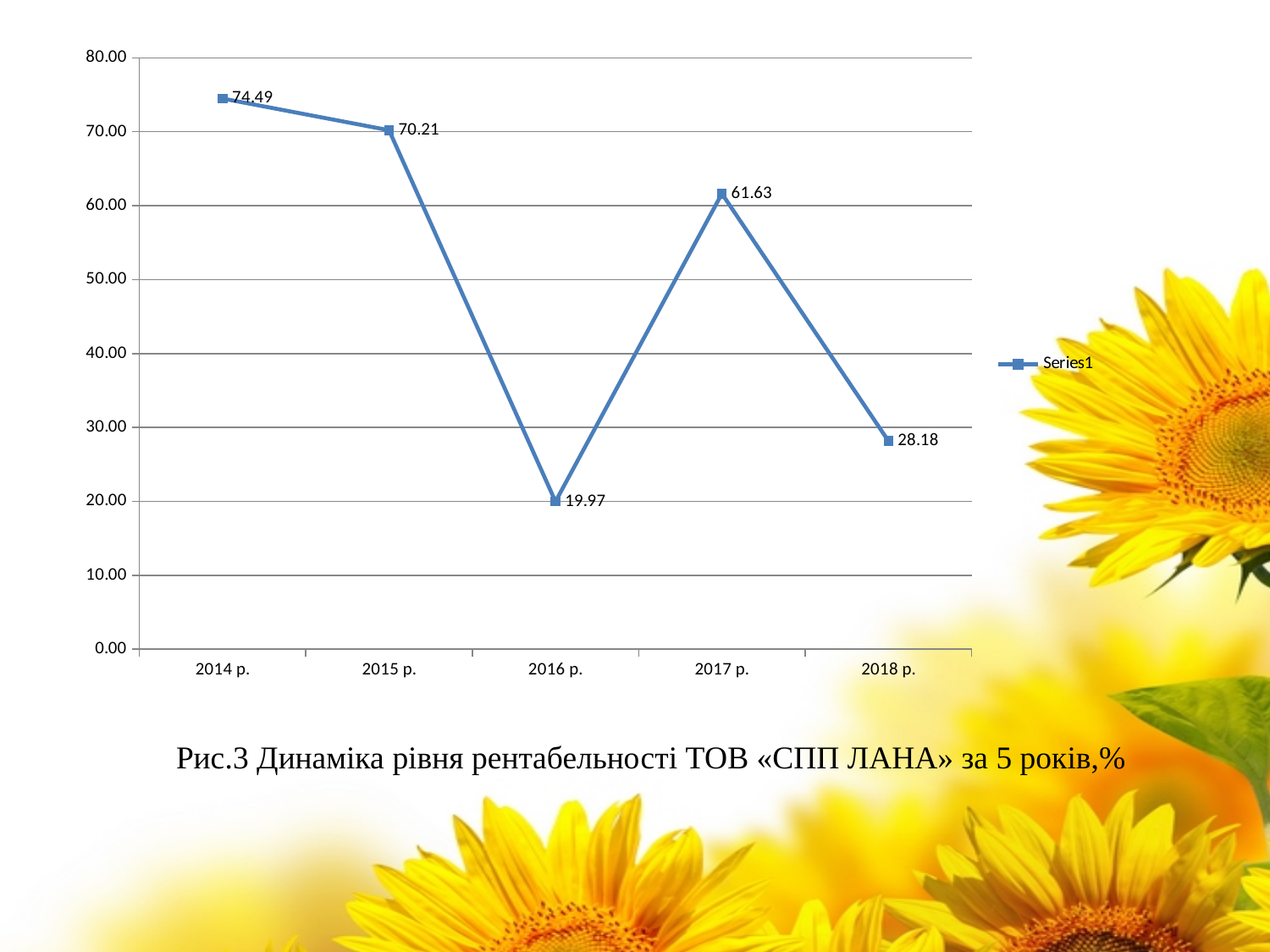
Does the value rise or fall from 2017 р. to 2018 р.? fall What is the difference between the values for 2014 р. and 2015 р.? 4.28 What kind of chart is shown on the slide? line chart What is the difference between the values for 2017 р. and 2016 р.? 41.66 How many series does the legend list? 1 Which year has the highest value? 2014 р. What is the value for 2016 р.? 19.97 Which year has the lowest value? 2016 р. Which is larger, the value for 2017 р. or the value for 2018 р.? 2017 р. How many years are plotted on the chart? 5 What is the value for 2018 р.? 28.18 What is the value for 2014 р.? 74.49